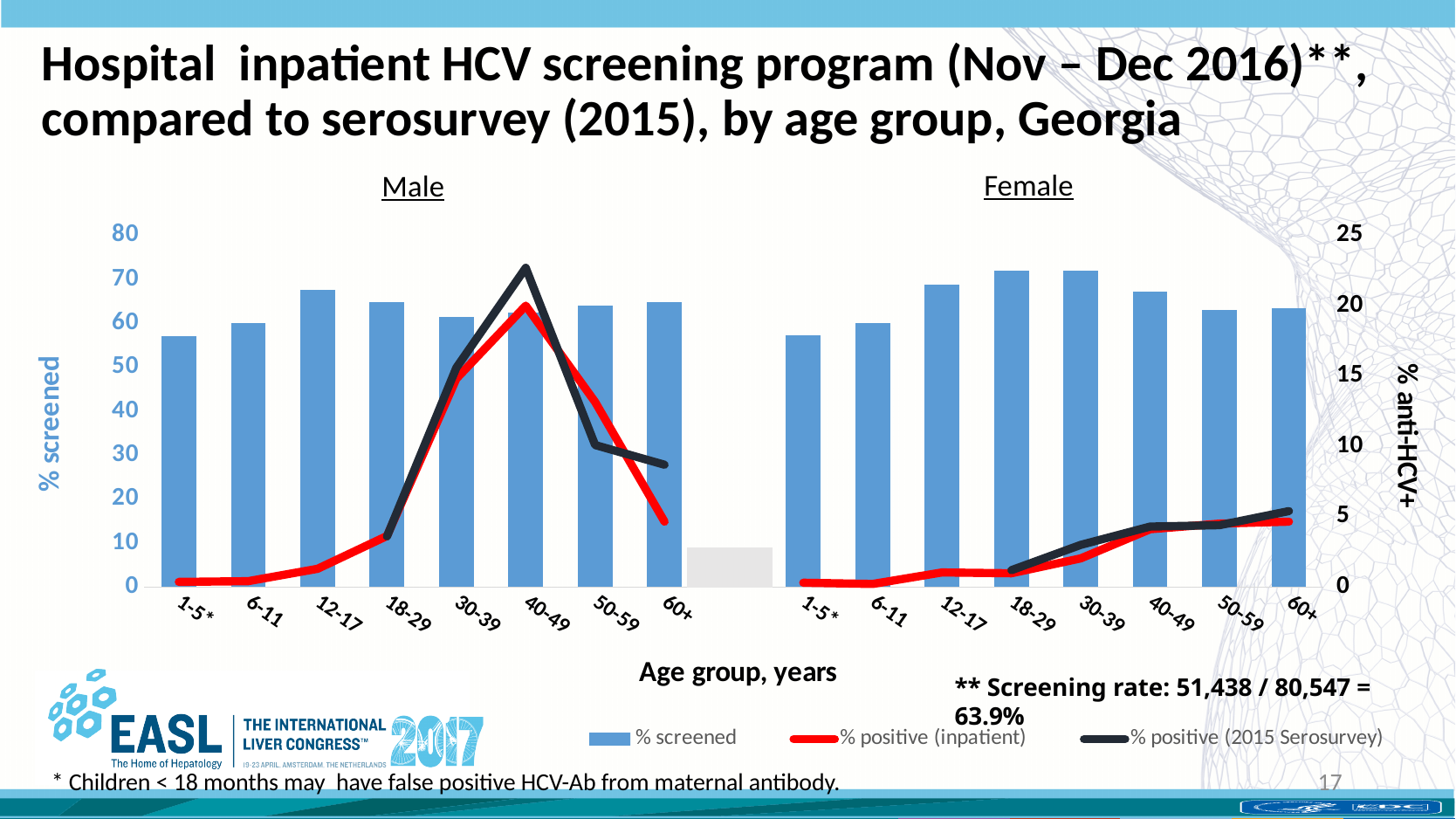
In the Female panel, is the % screened for the 1-5* age group greater or less than 60? less In the Male panel, is the % screened for the 12-17 age group greater or less than 60? greater In the Female panel, which age group has the highest % positive (2015 Serosurvey)? 60+ In the Female panel, does the % positive (2015 Serosurvey) rise or fall from the 18-29 age group to the 60+ age group? rise What kind of chart is shown on the slide? Combined bar and line chart In the Male panel, which age group has the highest % positive (inpatient)? 40-49 In the Male panel, which age group has the larger % positive (inpatient): 40-49 or 50-59? 40-49 What is the title of the left vertical axis of the chart? % screened In the Male panel, is the % positive (2015 Serosurvey) for the 40-49 age group greater or less than 20 on the right axis? greater How many age groups are plotted in the Male panel? 8 How many series does the chart legend list? 3